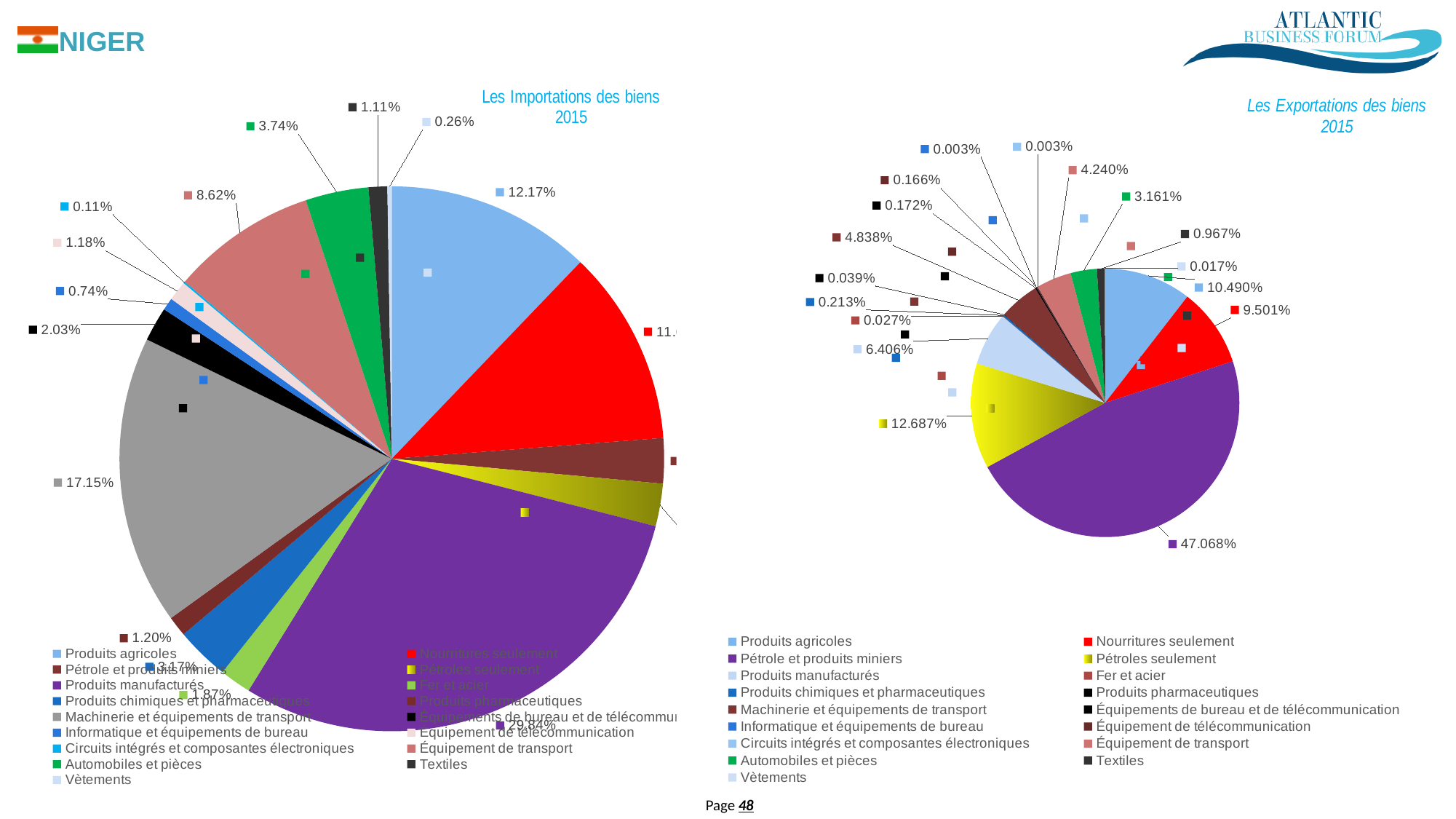
In 'Les Importations des biens 2015', what share does Produits manufacturés have? 29.84% In 'Les Importations des biens 2015', what is the value for Automobiles et pièces? 3.74% In 'Les Importations des biens 2015', what is the value for Machinerie et équipements de transport? 17.15% What kind of chart is 'Les Importations des biens 2015'? Pie chart In 'Les Exportations des biens 2015', which is larger: Produits agricoles or Nourritures seulement? Produits agricoles In 'Les Exportations des biens 2015', what is the value for Textiles? 0.967% In 'Les Importations des biens 2015', what is the difference between Produits agricoles and Équipement de transport? 3.55% In 'Les Importations des biens 2015', which category has the largest slice? Produits manufacturés How many categories does the legend of 'Les Exportations des biens 2015' list? 17 In 'Les Exportations des biens 2015', what share does Pétrole et produits miniers have? 47.068% In 'Les Exportations des biens 2015', which category has the largest slice? Pétrole et produits miniers In 'Les Exportations des biens 2015', what is the value for Pétroles seulement? 12.687%